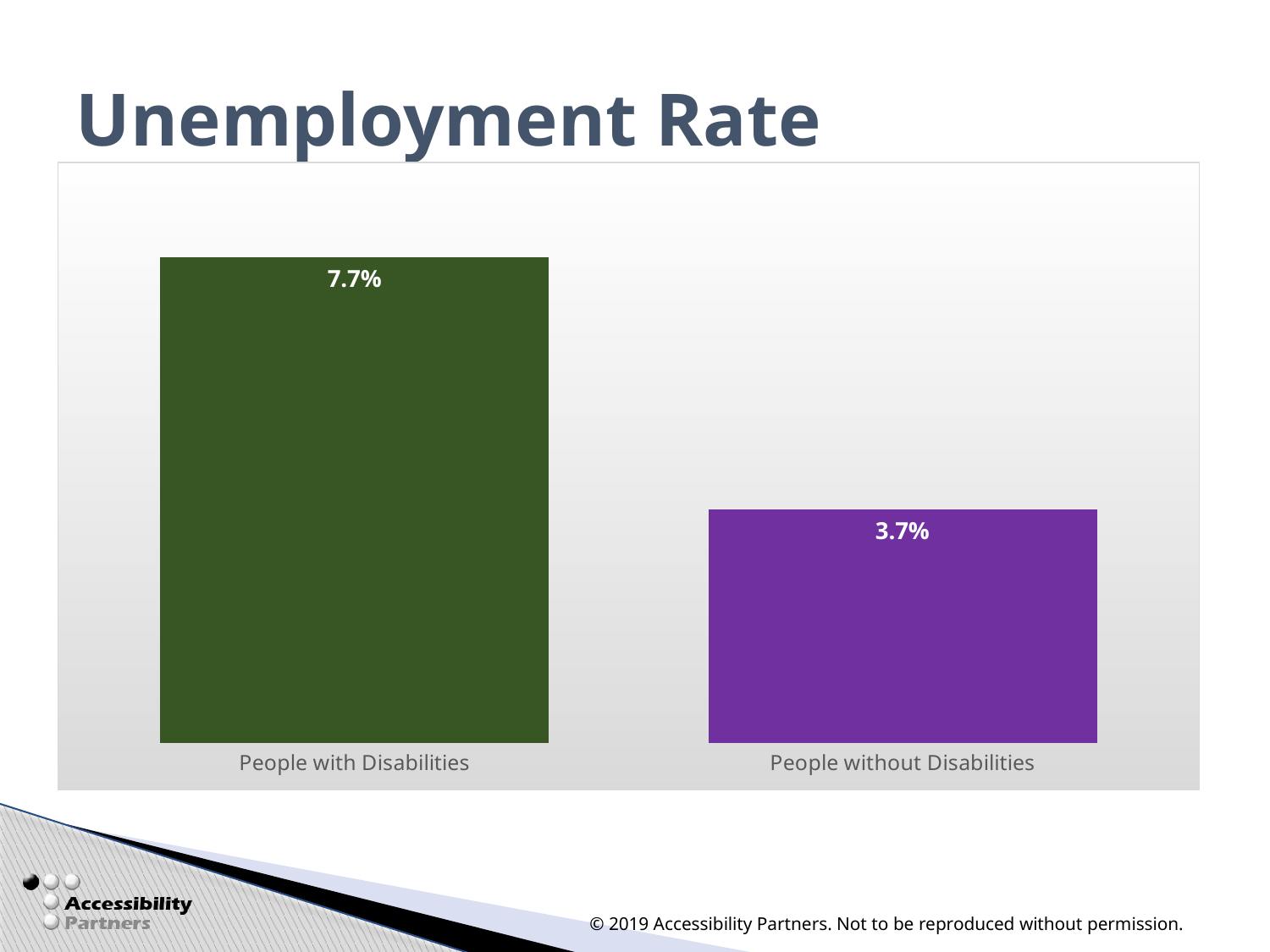
Is the unemployment rate for People with Disabilities larger or smaller than that for People without Disabilities? larger What is the title of the slide containing the chart? Unemployment Rate What kind of chart is shown on the slide? bar chart What is the unemployment rate for People without Disabilities? 3.7% Which category has the higher unemployment rate? People with Disabilities Which category has the lower unemployment rate? People without Disabilities What is the difference between the unemployment rate for People with Disabilities and People without Disabilities? 4.0% What colour is the bar for People without Disabilities? purple What is the unemployment rate for People with Disabilities? 7.7% How many categories are shown in the chart? 2